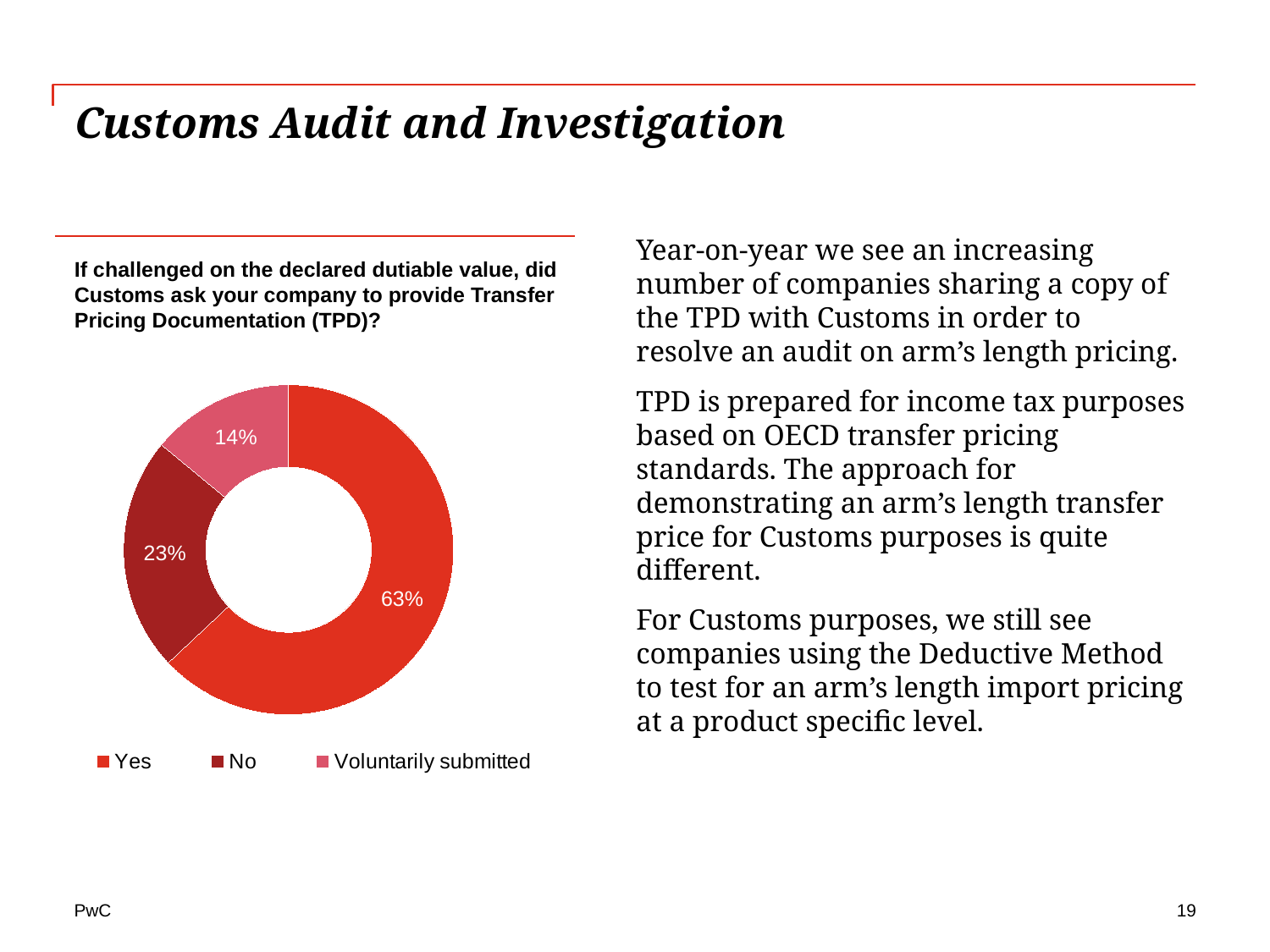
What percentage of respondents answered "Voluntarily submitted"? 14% What percentage of respondents answered "No"? 23% How many categories does the chart show? 3 What percentage of respondents answered "Yes"? 63% Which is larger, the share for "No" or the share for "Voluntarily submitted"? No What question does the chart title ask? If challenged on the declared dutiable value, did Customs ask your company to provide Transfer Pricing Documentation (TPD)? Which legend entry is shown in pink? Voluntarily submitted What kind of chart is shown on the slide? Doughnut chart Which response has the largest share of the chart? Yes What is the difference in percentage points between the "Yes" and "No" shares? 40 What is the difference in percentage points between the "No" and "Voluntarily submitted" shares? 9 Which response has the smallest share of the chart? Voluntarily submitted